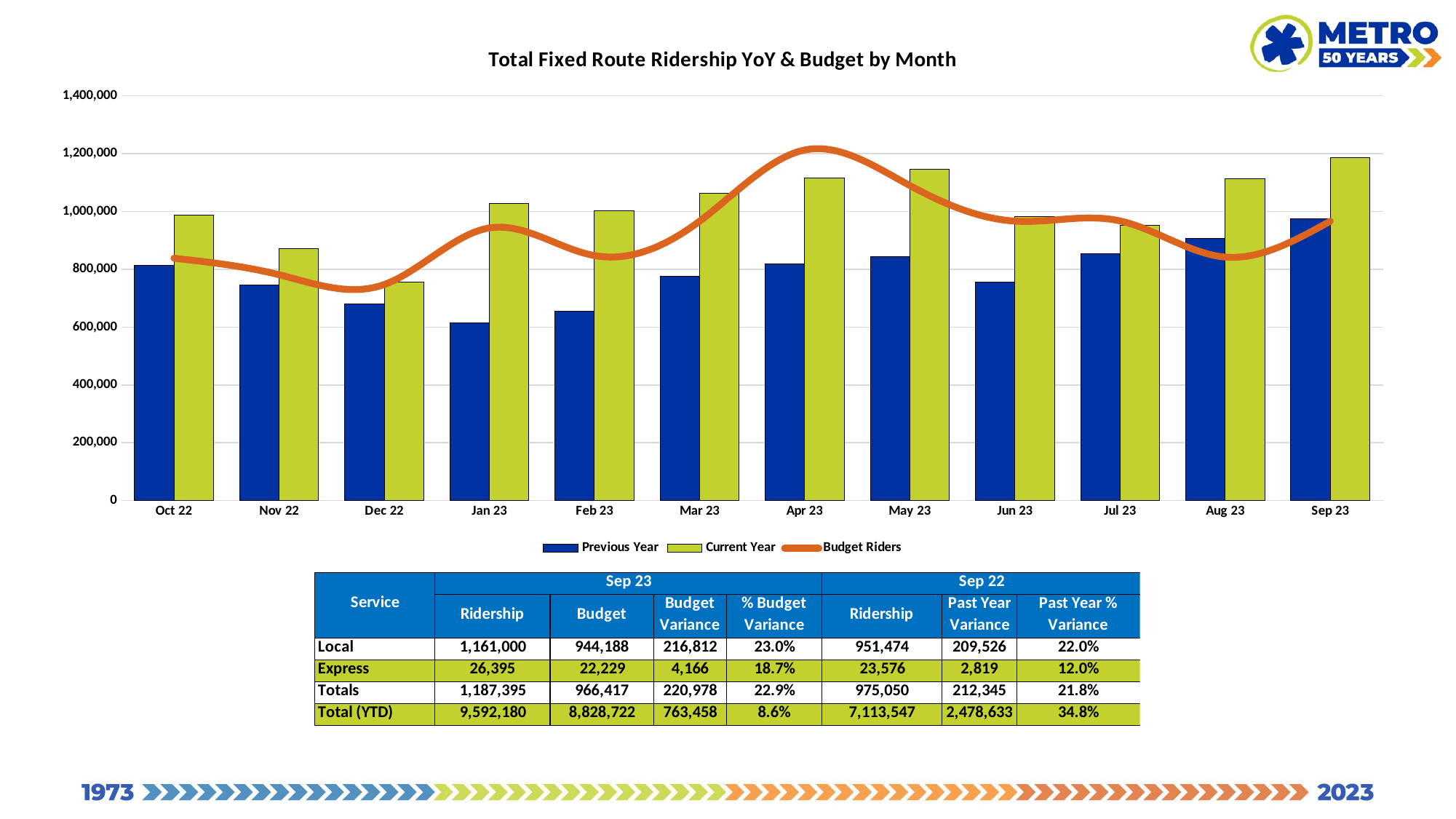
Is the Previous Year value for Jan 23 greater or less than 800,000? less Which month has the highest Previous Year bar? Sep 23 Which month has the lowest Previous Year bar? Jan 23 In Oct 22, which is larger, the Previous Year bar or the Current Year bar? Current Year What colour is the Budget Riders line in the chart? orange In which month does the Budget Riders line reach its highest point? Apr 23 What kind of chart is shown on the slide? bar chart with a line Is the Current Year value for Apr 23 greater or less than 1,000,000? greater Which month has the highest Current Year bar? Sep 23 Which month has the lowest Current Year bar? Dec 22 How many series does the chart legend list? 3 How many months are shown on the x axis of the chart? 12